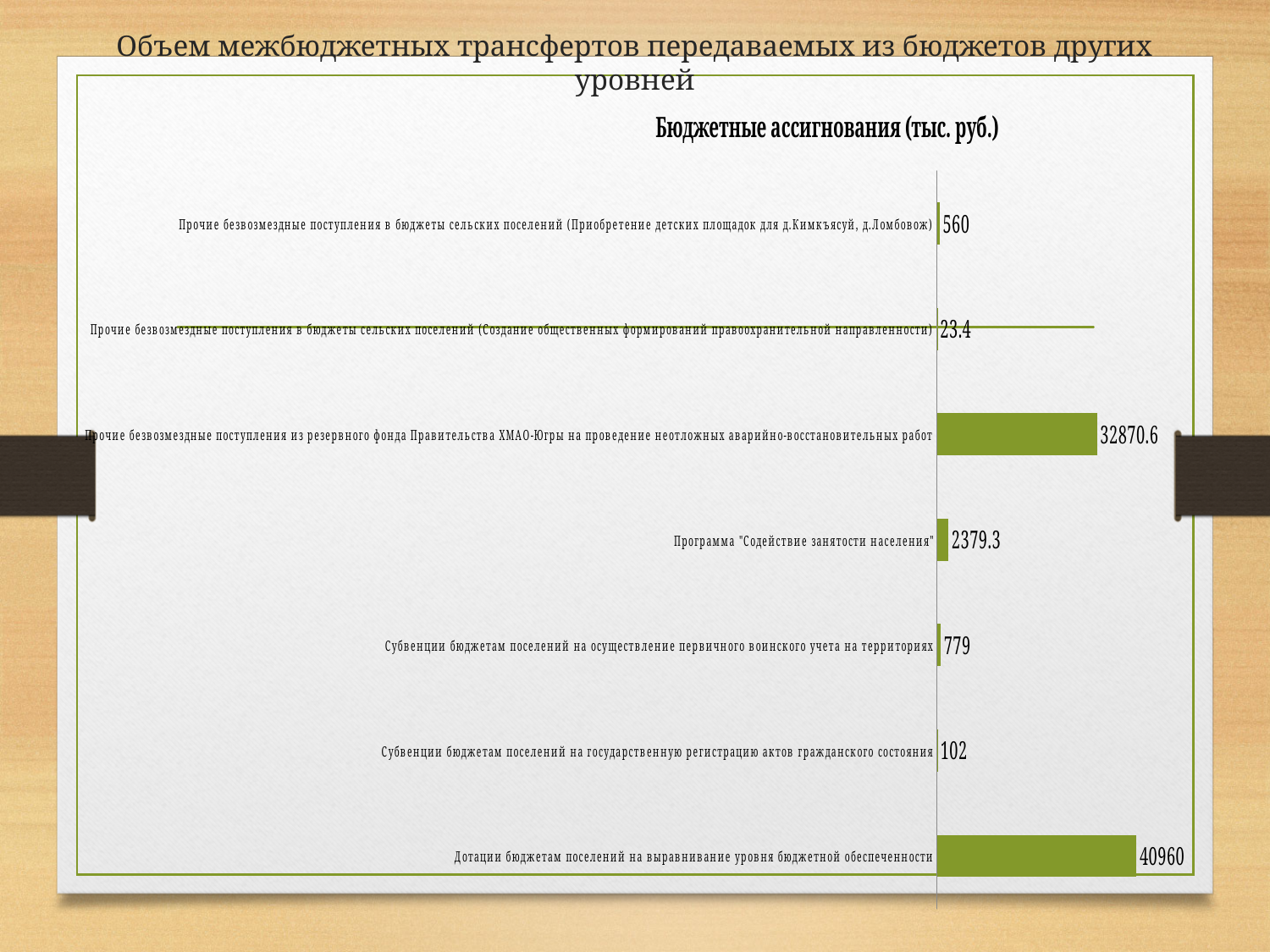
What is the value for "Субвенции бюджетам поселений на государственную регистрацию актов гражданского состояния"? 102 What type of chart is shown on the slide? bar chart How many categories are plotted in the chart? 7 What is the value for "Прочие безвозмездные поступления из резервного фонда Правительства ХМАО-Югры на проведение неотложных аварийно-восстановительных работ"? 32870.6 Which category has the lowest value? Прочие безвозмездные поступления в бюджеты сельских поселений (Создание общественных формирований правоохранительной направленности) What is the value for "Дотации бюджетам поселений на выравнивание уровня бюджетной обеспеченности"? 40960 What is the value for "Субвенции бюджетам поселений на осуществление первичного воинского учета на территориях"? 779 What is the title of the chart? Бюджетные ассигнования (тыс. руб.) What is the difference between the value for "Дотации бюджетам поселений на выравнивание уровня бюджетной обеспеченности" and the value for "Прочие безвозмездные поступления из резервного фонда Правительства ХМАО-Югры на проведение неотложных аварийно-восстановительных работ"? 8089.4 Which is larger: the value for "Субвенции бюджетам поселений на осуществление первичного воинского учета на территориях" or the value for "Прочие безвозмездные поступления в бюджеты сельских поселений (Приобретение детских площадок для д.Кимкъясуй, д.Ломбовож)"? Субвенции бюджетам поселений на осуществление первичного воинского учета на территориях Which category has the highest value? Дотации бюджетам поселений на выравнивание уровня бюджетной обеспеченности What is the value for "Программа "Содействие занятости населения""? 2379.3